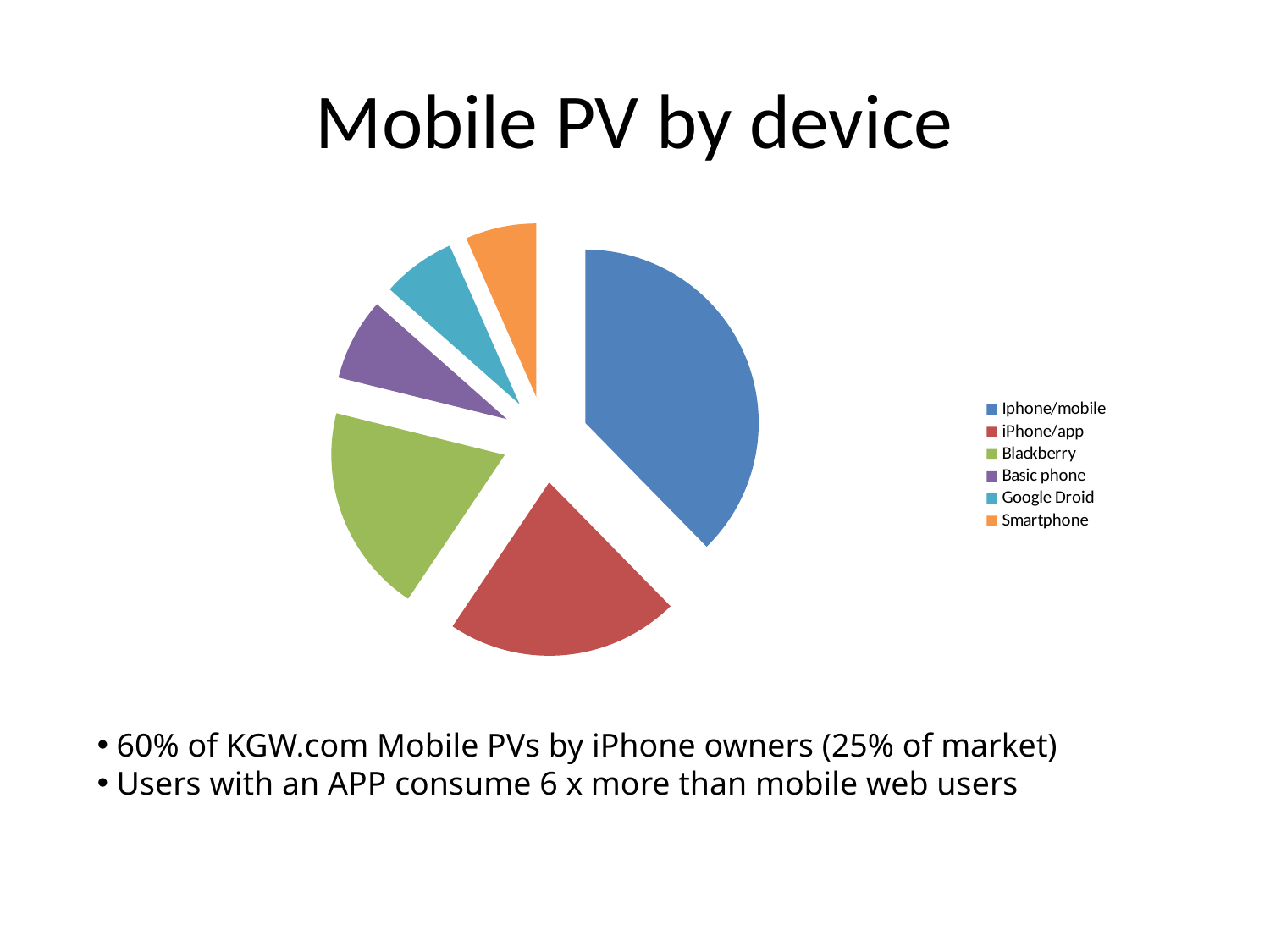
Which device category has the largest slice of the pie? Iphone/mobile How many categories (slices) does the pie chart have? 6 How many entries does the legend list? 6 Which slice is larger, Blackberry or Basic phone? Blackberry What kind of chart is shown on the slide? pie chart What is the title of the chart? Mobile PV by device Which slice is larger, Iphone/mobile or Smartphone? Iphone/mobile Which slice is larger, iPhone/app or Google Droid? iPhone/app What colour is the Blackberry slice in the pie chart? green